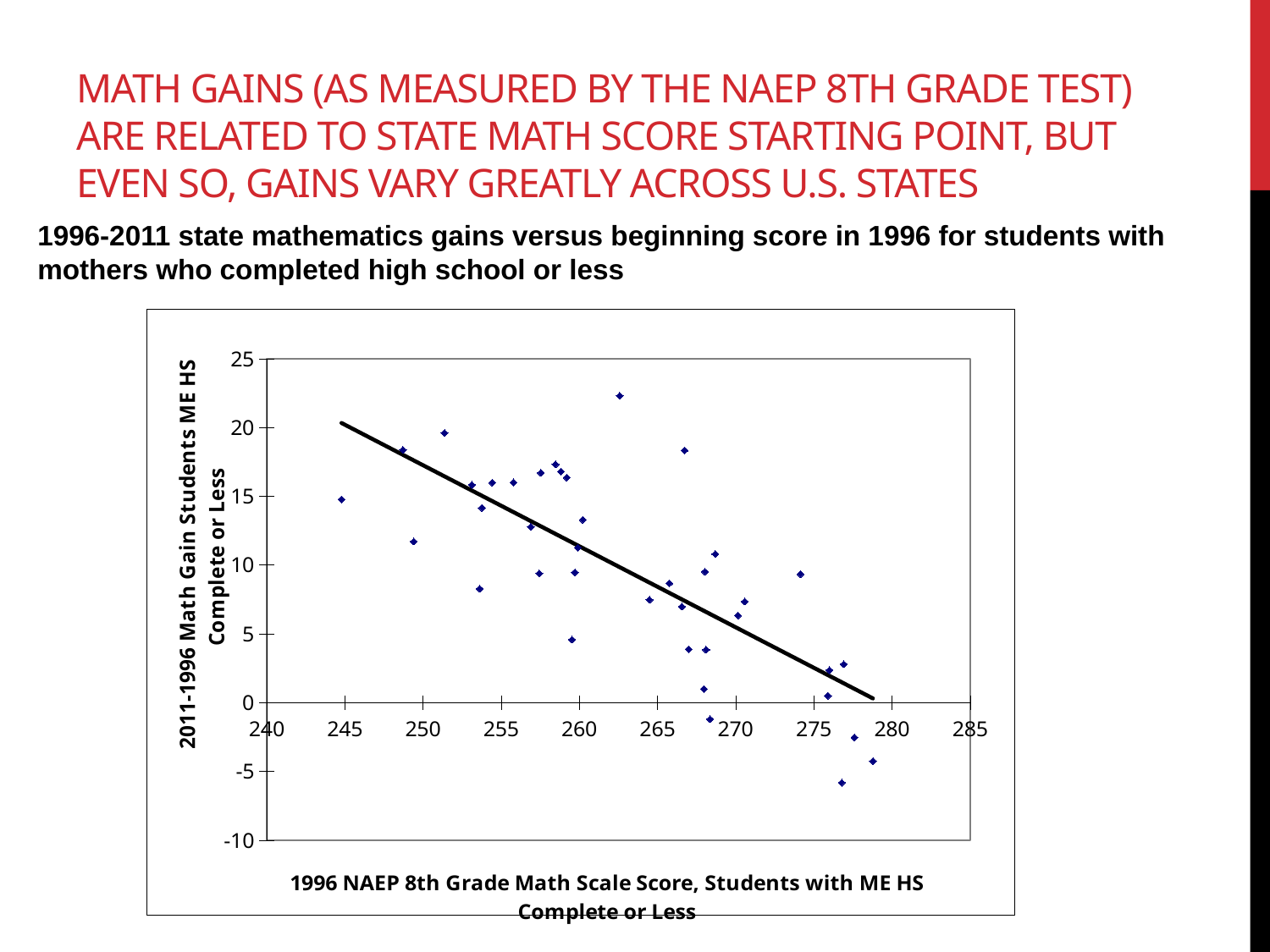
What is the label of the x axis? 1996 NAEP 8th Grade Math Scale Score, Students with ME HS Complete or Less Is the math gain for the point with the lowest 1996 score (near 245) greater or less than 10? greater What kind of chart is shown on the slide? Scatter plot Does the fitted trend line on the chart slope upward or downward from left to right? Downward What is the lowest value shown on the y axis? -10 Is the highest plotted math gain on the chart greater or less than 20? greater As the 1996 NAEP 8th grade math scale score increases along the x axis, do the 2011-1996 math gains generally rise or fall? Fall Is the lowest plotted math gain on the chart greater or less than 0? less